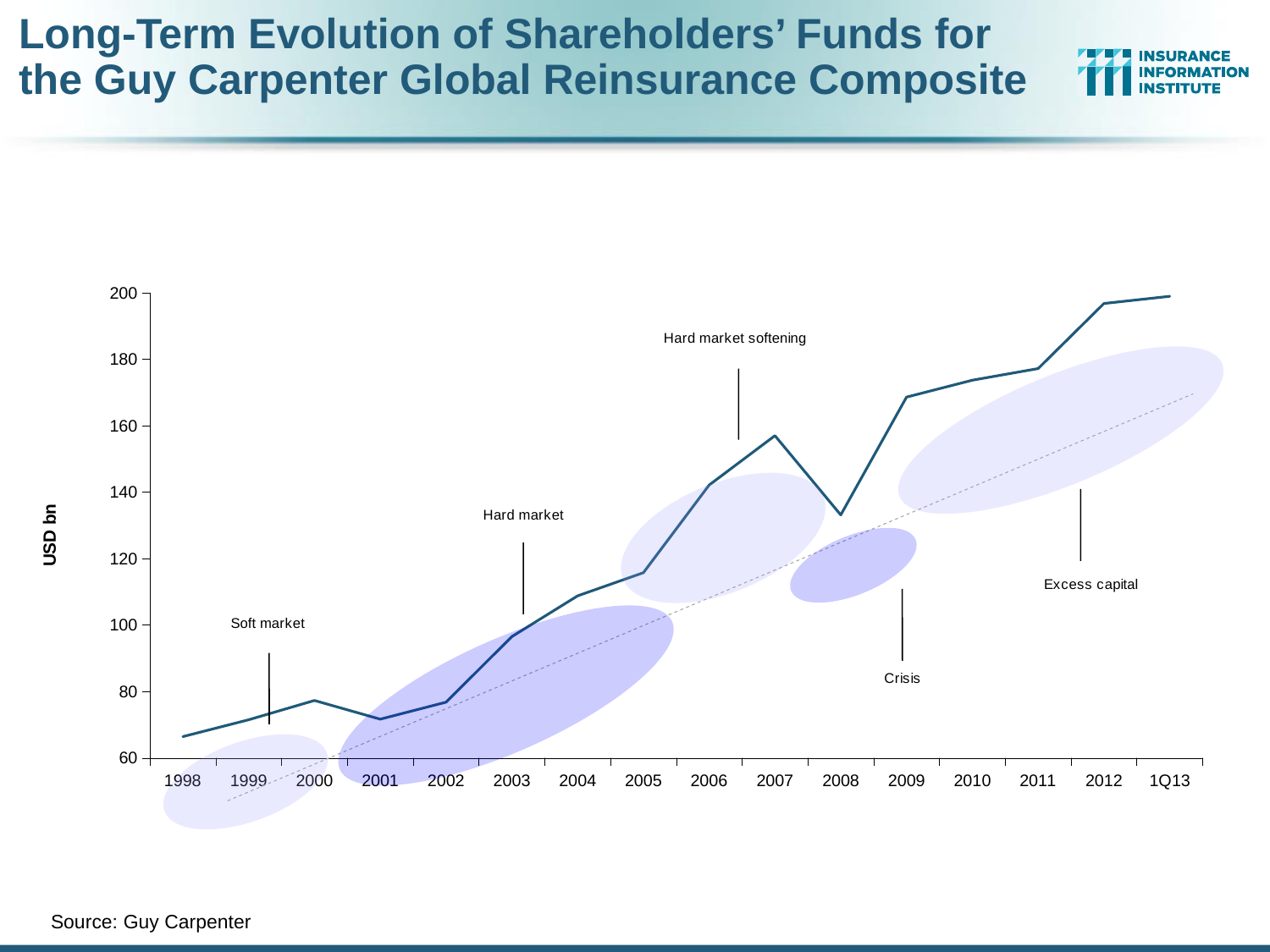
Which is larger, the value for 2000 or the value for 2001? 2000 Overall, do shareholders' funds rise or fall from 1998 to 1Q13? Rise Is the value for 2008 greater or less than 140? less Is the value for 2001 greater or less than 80? less What is the label on the y axis? USD bn Which is larger, the value for 2007 or the value for 2008? 2007 Which annotation is placed near the 2008 dip in the line? Crisis Is the value for 2012 greater or less than 180? greater What kind of chart is shown on the slide? Line chart How many time points are plotted along the x axis? 16